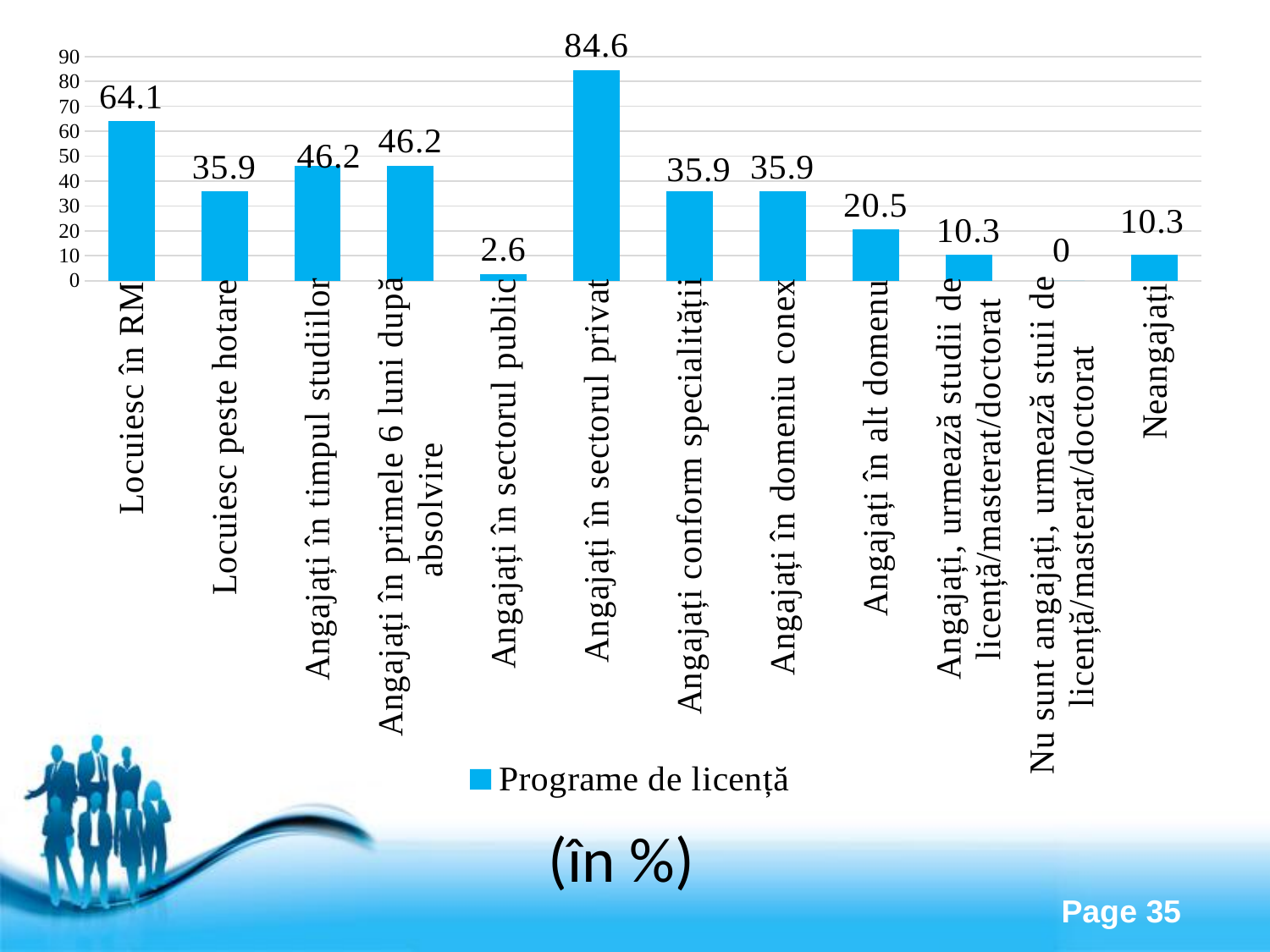
What is the value for "Angajați în alt domeniu"? 20.5 What series name does the legend show? Programe de licență How many categories are shown on the x axis? 12 Which category has the lowest value? Nu sunt angajați, urmează stuii de licență/masterat/doctorat What is the value for "Angajați în sectorul public"? 2.6 What is the value for "Neangajați"? 10.3 What is the difference between the values for "Angajați în sectorul privat" and "Angajați în sectorul public"? 82 Which is larger: the value for "Locuiesc în RM" or the value for "Locuiesc peste hotare"? Locuiesc în RM Is the value for "Angajați în timpul studiilor" greater or less than 40? greater Which category has the highest value? Angajați în sectorul privat What is the value for "Locuiesc în RM"? 64.1 What kind of chart is shown on the slide? bar chart